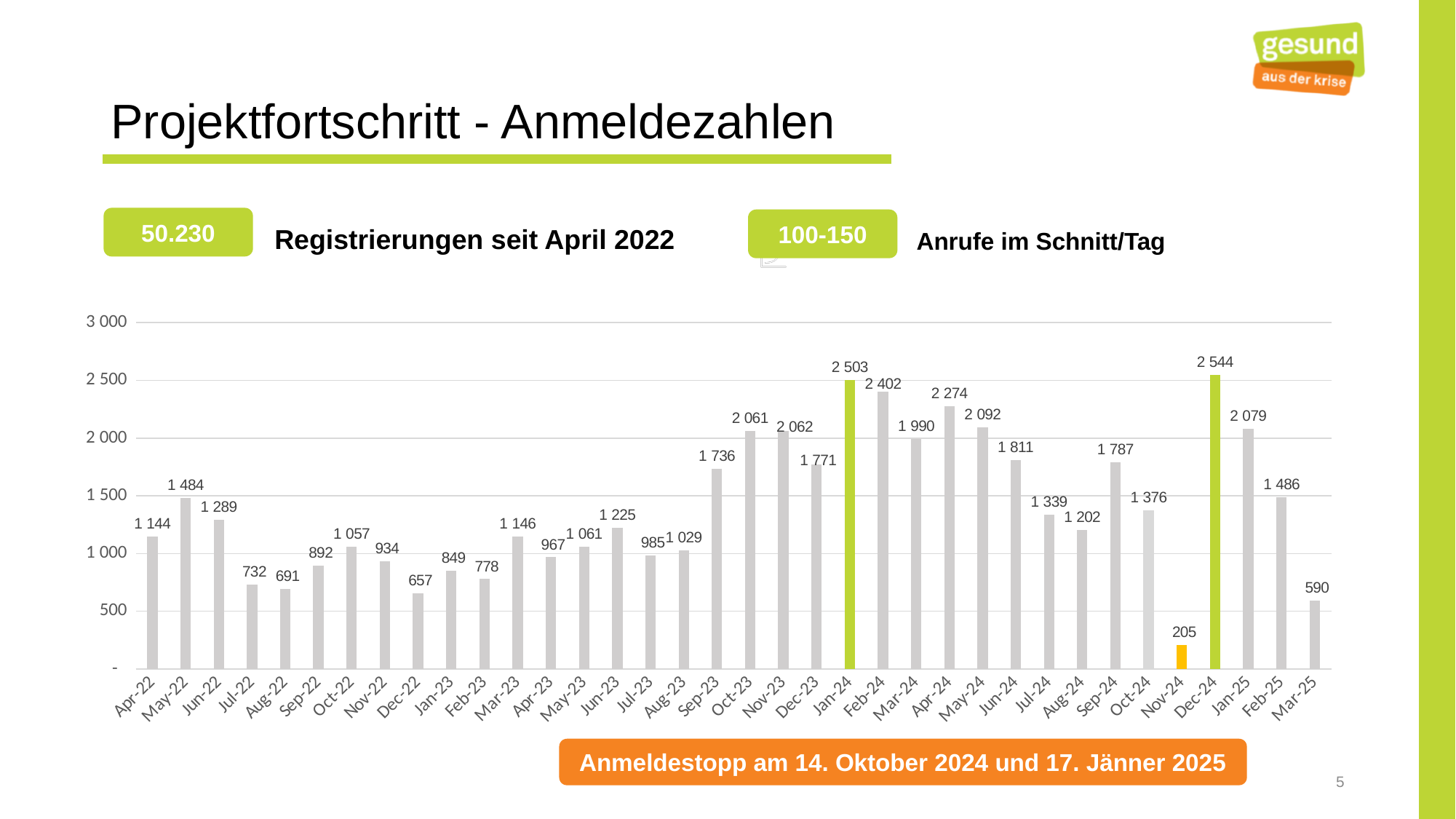
What kind of chart is shown on the slide? bar chart What is the value for Nov-24? 205 What is the value for Sep-23? 1 736 What is the difference between the values for Sep-23 and Aug-23? 707 What is the difference between the values for Dec-24 and Jan-24? 41 Which month has the highest value? Dec-24 Is the value for Jul-22 greater or less than 1 000? less What is the value for Jan-24? 2 503 Do the values rise or fall from Dec-24 to Mar-25? fall How many months are shown on the x axis? 36 Which is larger, the value for Apr-24 or the value for May-24? Apr-24 Which month has the lowest value? Nov-24